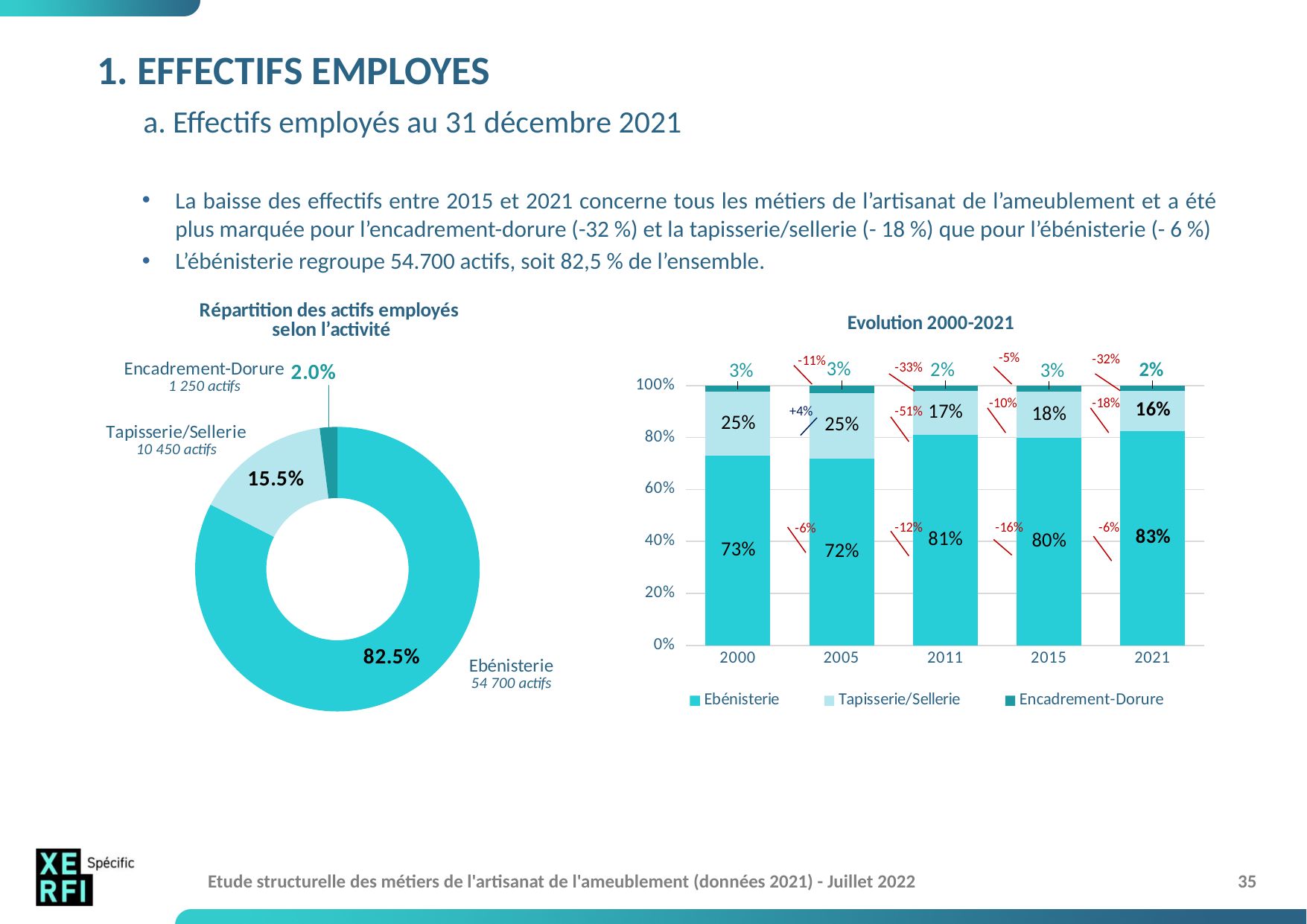
What kind of chart is 'Répartition des actifs employés selon l'activité'? Doughnut chart How many series does the legend of the 'Evolution 2000-2021' chart list? 3 In the 'Répartition des actifs employés selon l'activité' chart, what share does Ebénisterie hold? 82.5% In the 'Evolution 2000-2021' chart, in which year is the Ebénisterie share the lowest? 2005 In the 'Répartition des actifs employés selon l'activité' chart, what share does Tapisserie/Sellerie hold? 15.5% In the 'Répartition des actifs employés selon l'activité' chart, which activity has the smallest share? Encadrement-Dorure In the 'Répartition des actifs employés selon l'activité' chart, how many actifs does Tapisserie/Sellerie have? 10 450 actifs In the 'Evolution 2000-2021' chart, what is the difference between the Tapisserie/Sellerie share in 2000 and in 2021? 9 percentage points In the 'Evolution 2000-2021' chart, how many years are shown on the x axis? 5 In the 'Evolution 2000-2021' chart, what is the value for Ebénisterie in 2021? 83% In the 'Evolution 2000-2021' chart, what is the value for Tapisserie/Sellerie in 2011? 17% In the 'Evolution 2000-2021' chart, is the Ebénisterie share in 2000 larger or smaller than in 2015? Smaller